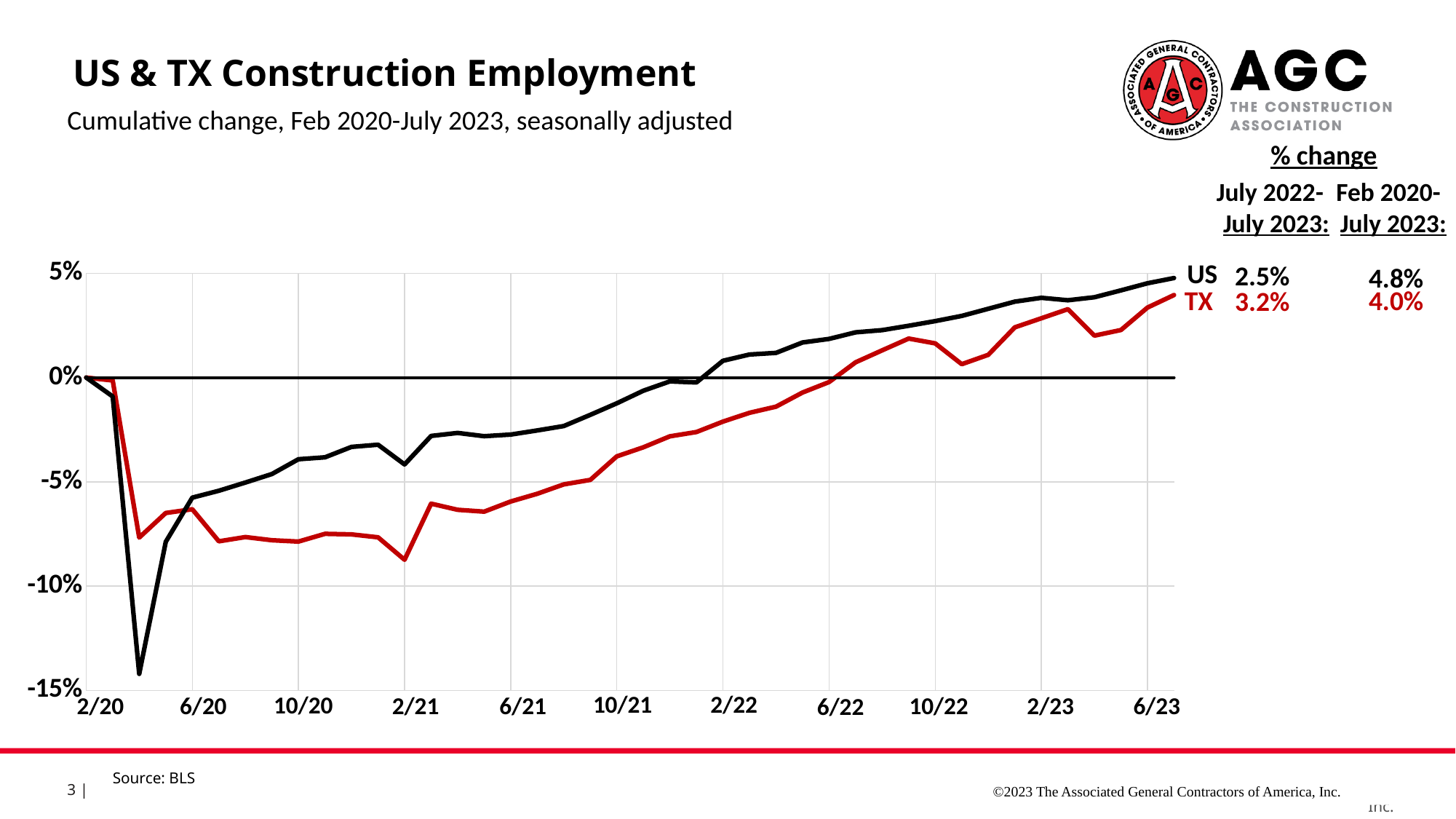
What is the percent change in US construction employment from July 2022 to July 2023? 2.5% What is the cumulative percent change in US construction employment from Feb 2020 to July 2023? 4.8% Which series fell to a lower minimum in 2020, US or TX? US Is the lowest value reached by the TX line greater or less than -10%? greater What is the cumulative percent change in TX construction employment from Feb 2020 to July 2023? 4.0% What is the difference between the US and TX cumulative changes from Feb 2020 to July 2023? 0.8 percentage points How many series are plotted on the chart? 2 Which series ends higher at the end of the chart (July 2023), US or TX? US What colour is the TX line on the chart? red What is the percent change in TX construction employment from July 2022 to July 2023? 3.2% Is the lowest value reached by the US line greater or less than -10%? less What kind of chart is shown on the slide? line chart